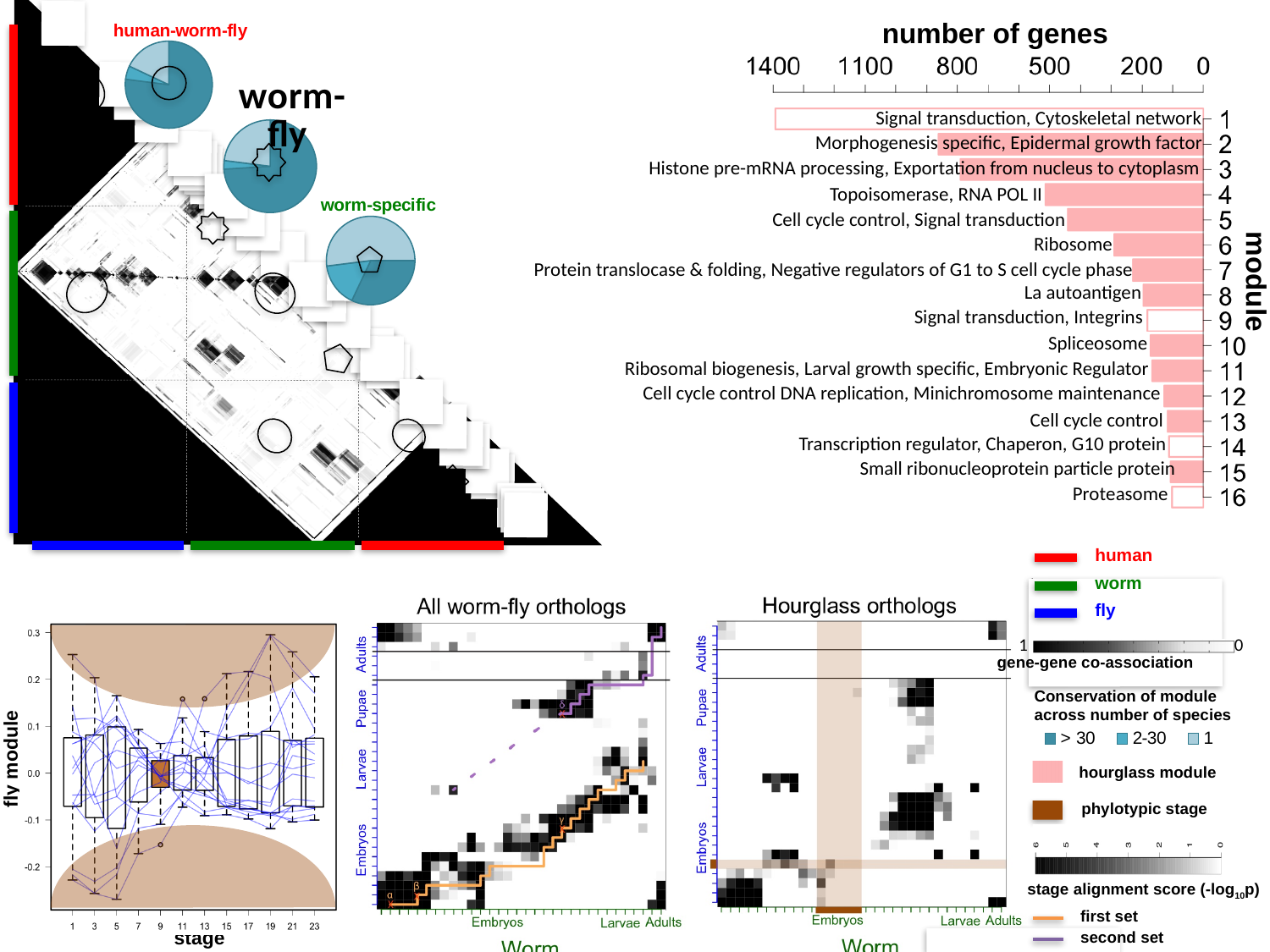
In the 'number of genes' chart, how many modules are listed? 16 What are the titles of the two heatmaps at the bottom centre of the slide? All worm-fly orthologs; Hourglass orthologs In the 'number of genes' chart, do the bar lengths generally increase or decrease as the module number goes from 1 to 16? decrease In the 'number of genes' chart, which has more genes: module 2 (Morphogenesis specific, Epidermal growth factor) or module 6 (Ribosome)? Module 2 In the 'number of genes' chart, which module has the largest number of genes? Module 1 (Signal transduction, Cytoskeletal network) In the 'number of genes' chart, is the value for module 16 (Proteasome) greater or less than 200? less What kind of chart is the bottom-left chart with 'stage' on the x axis and 'fly module' on the y axis? box plot What is the label on the vertical axis of the 'number of genes' chart? module In the 'number of genes' chart, is the value for module 4 (Topoisomerase, RNA POL II) greater or less than 800? less In the 'number of genes' chart, is the value for module 2 (Morphogenesis specific, Epidermal growth factor) greater or less than 500? greater What kind of chart is the 'number of genes' chart in the top right of the slide? bar chart